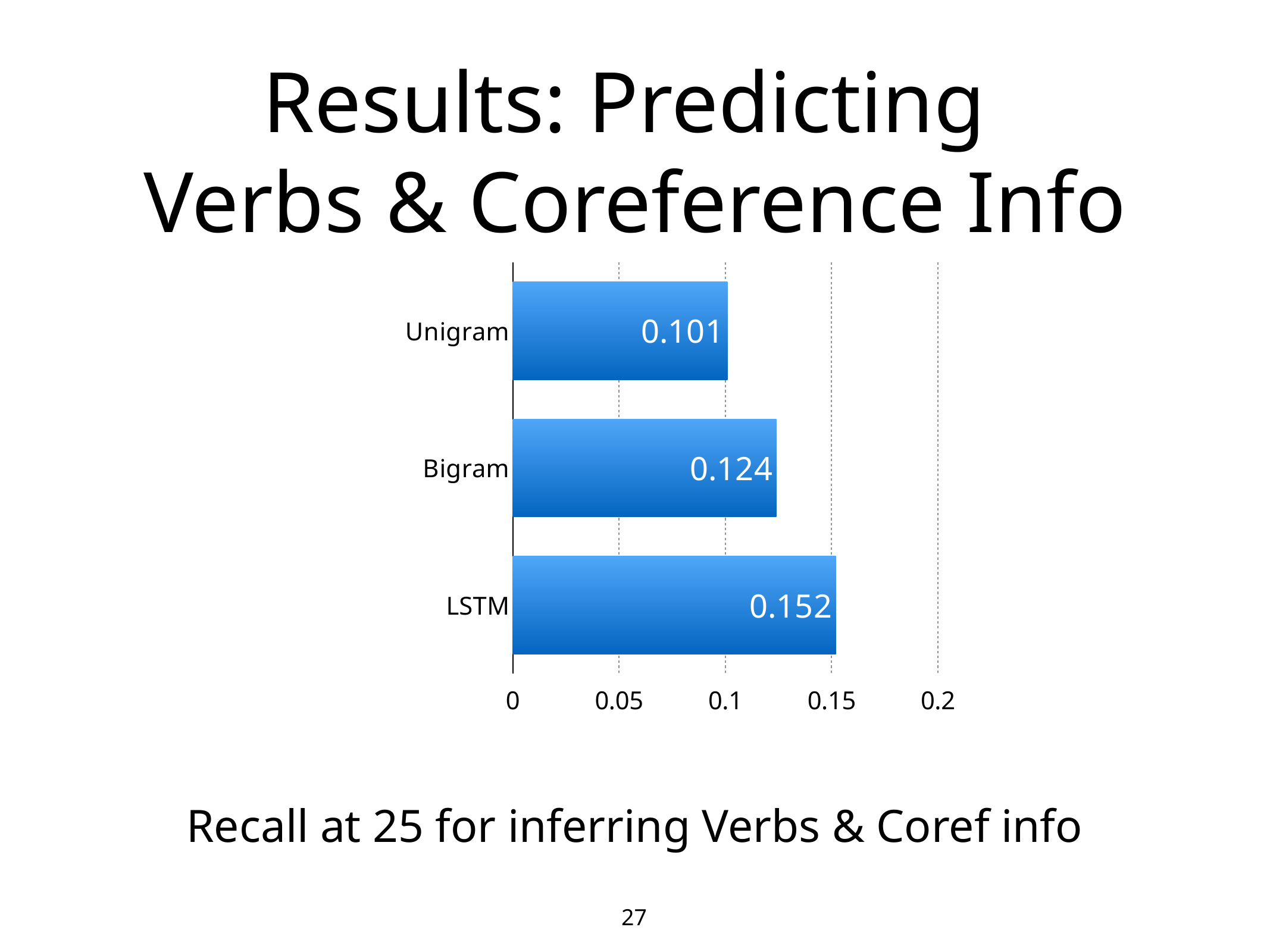
What is the value for Bigram? 0.124 What kind of chart is shown on the slide? bar chart Is the value for LSTM greater or less than 0.15? greater Which category has the highest value? LSTM What is the difference between the LSTM and Unigram values? 0.051 What is the value for Unigram? 0.101 How many categories are shown in the chart? 3 What is the difference between the Bigram and Unigram values? 0.023 Which category has the lowest value? Unigram Which is larger, the value for Bigram or the value for Unigram? Bigram What is the value for LSTM? 0.152 What is the maximum value shown on the horizontal axis? 0.2